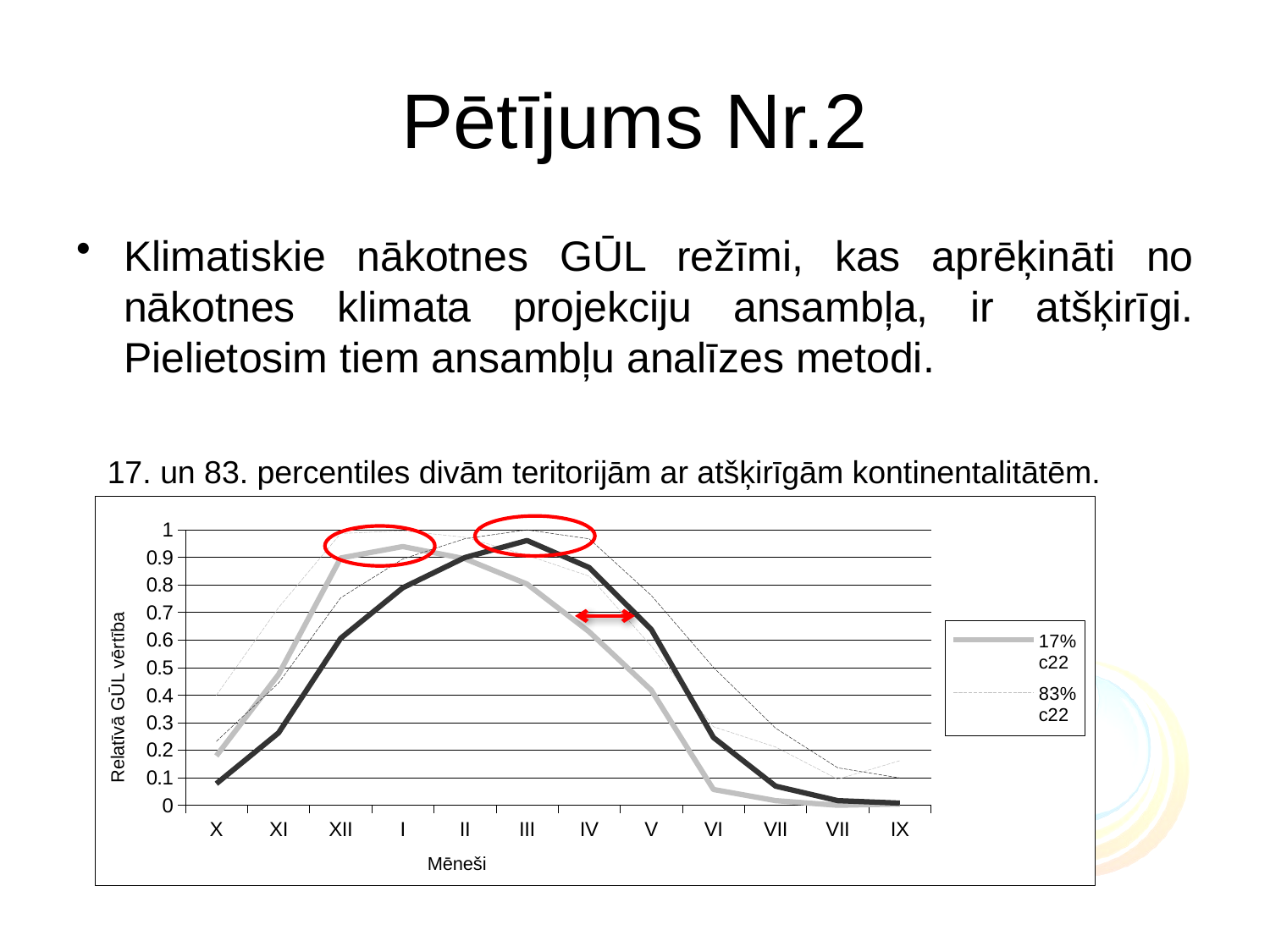
What is the title of the x axis of the chart? Mēneši Is the value of the 17% c22 series at month X greater or less than 0.5? less Does the 17% c22 series rise or fall from month X to month I? rise Which is larger for the 17% c22 series: the value at month XII or the value at month V? XII Is the value of the 17% c22 series at month VI greater or less than 0.2? less What is the title of the y axis of the chart? Relatīvā GŪL vērtība How many month categories are shown along the x axis of the chart? 12 Does the 17% c22 series rise or fall from month I to month VI? fall Is the value of the 17% c22 series at month XII greater or less than 0.7? greater What kind of chart is shown on the slide? line chart How many series does the chart legend list? 2